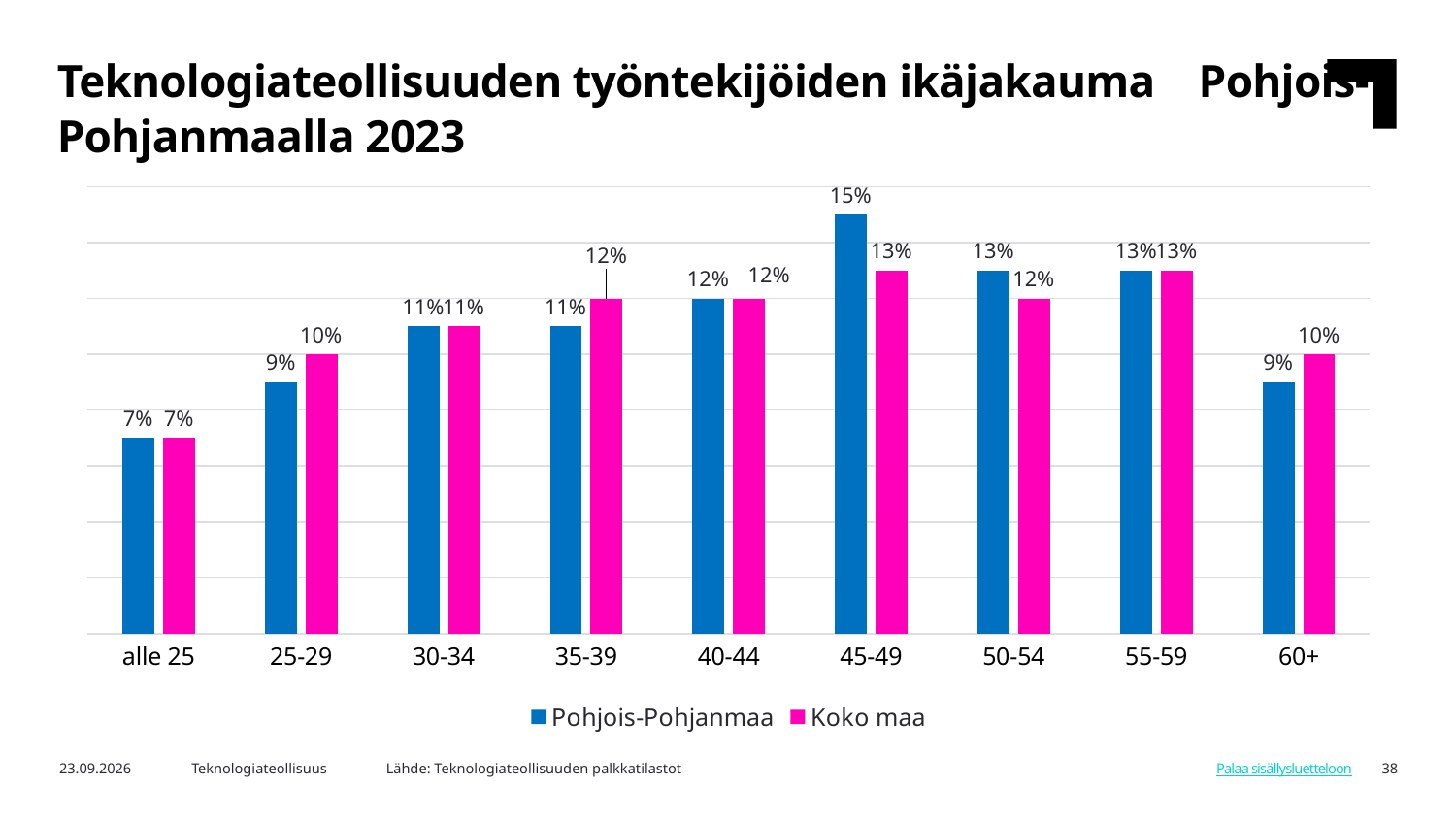
In the 50-54 age group, which series has the larger value, Pohjois-Pohjanmaa or Koko maa? Pohjois-Pohjanmaa How many series does the legend list? 2 Which age group has the lowest value for Koko maa? alle 25 What is the value for Pohjois-Pohjanmaa in the 60+ age group? 9% How many age groups are shown on the x axis? 9 What is the difference between the Pohjois-Pohjanmaa and Koko maa values in the 45-49 age group? 2 percentage points What kind of chart is shown on the slide? Bar chart Which colour represents Koko maa in the chart? Pink Which age group has the highest value for Pohjois-Pohjanmaa? 45-49 What is the value for Koko maa in the 35-39 age group? 12% What is the value for Koko maa in the 25-29 age group? 10% What is the value for Pohjois-Pohjanmaa in the 45-49 age group? 15%